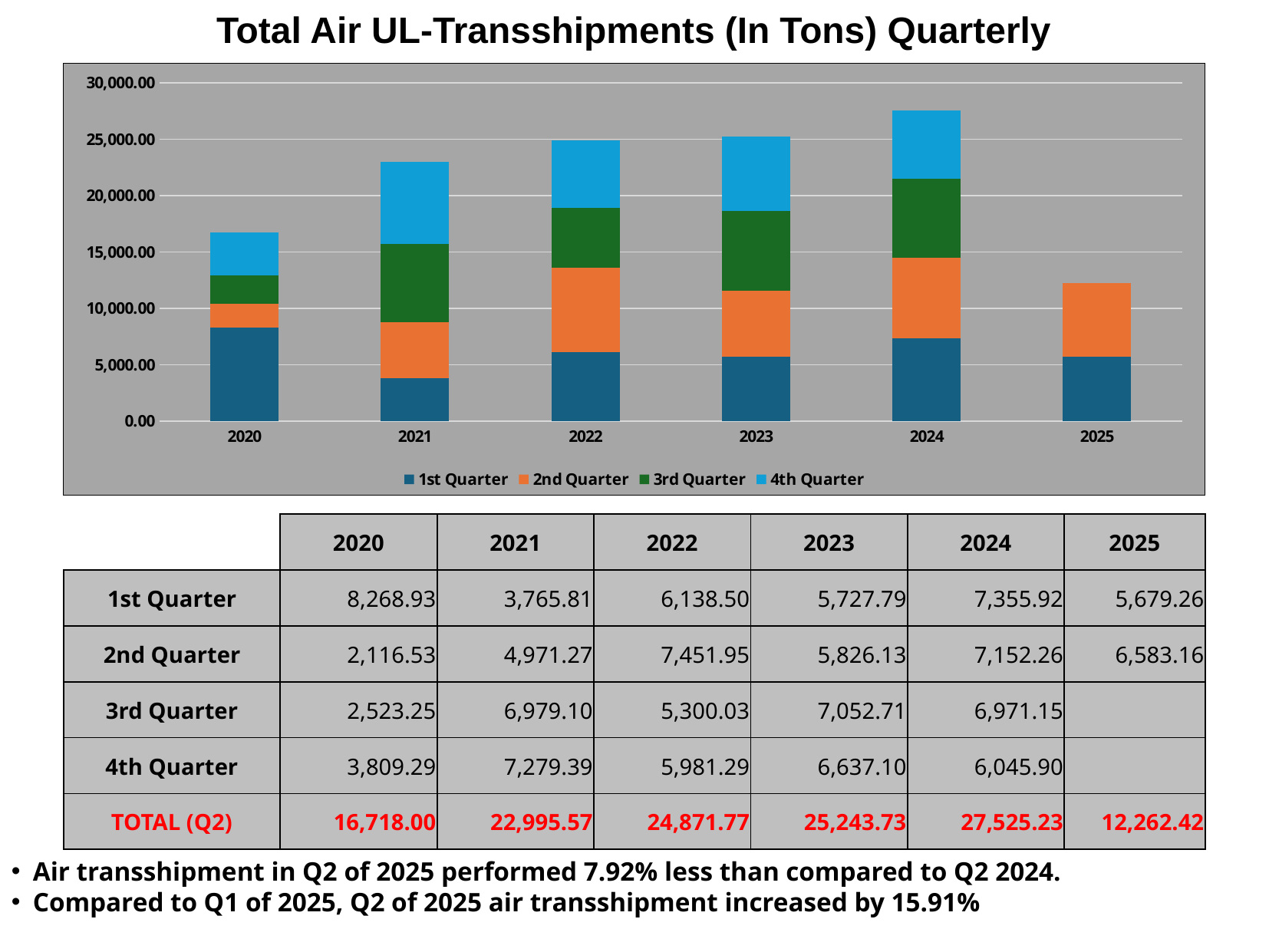
Which is larger, the 1st Quarter value for 2020 or the 1st Quarter value for 2021? 2020 How many years are shown along the x axis? 6 What colour represents the 4th Quarter in the legend? Light blue What is the difference between the 2nd Quarter and 1st Quarter values for 2025? 903.90 How many series does the legend list? 4 What is the 1st Quarter value for 2020? 8,268.93 Which year has the highest total air UL-transshipments? 2024 What is the total of the stacked bar for 2021? 22,995.57 What is the 3rd Quarter value for 2023? 7,052.71 What kind of chart is shown on the slide? Stacked bar chart Is the total for 2024 greater or less than 25,000.00? greater Which year has the lowest total air UL-transshipments? 2025